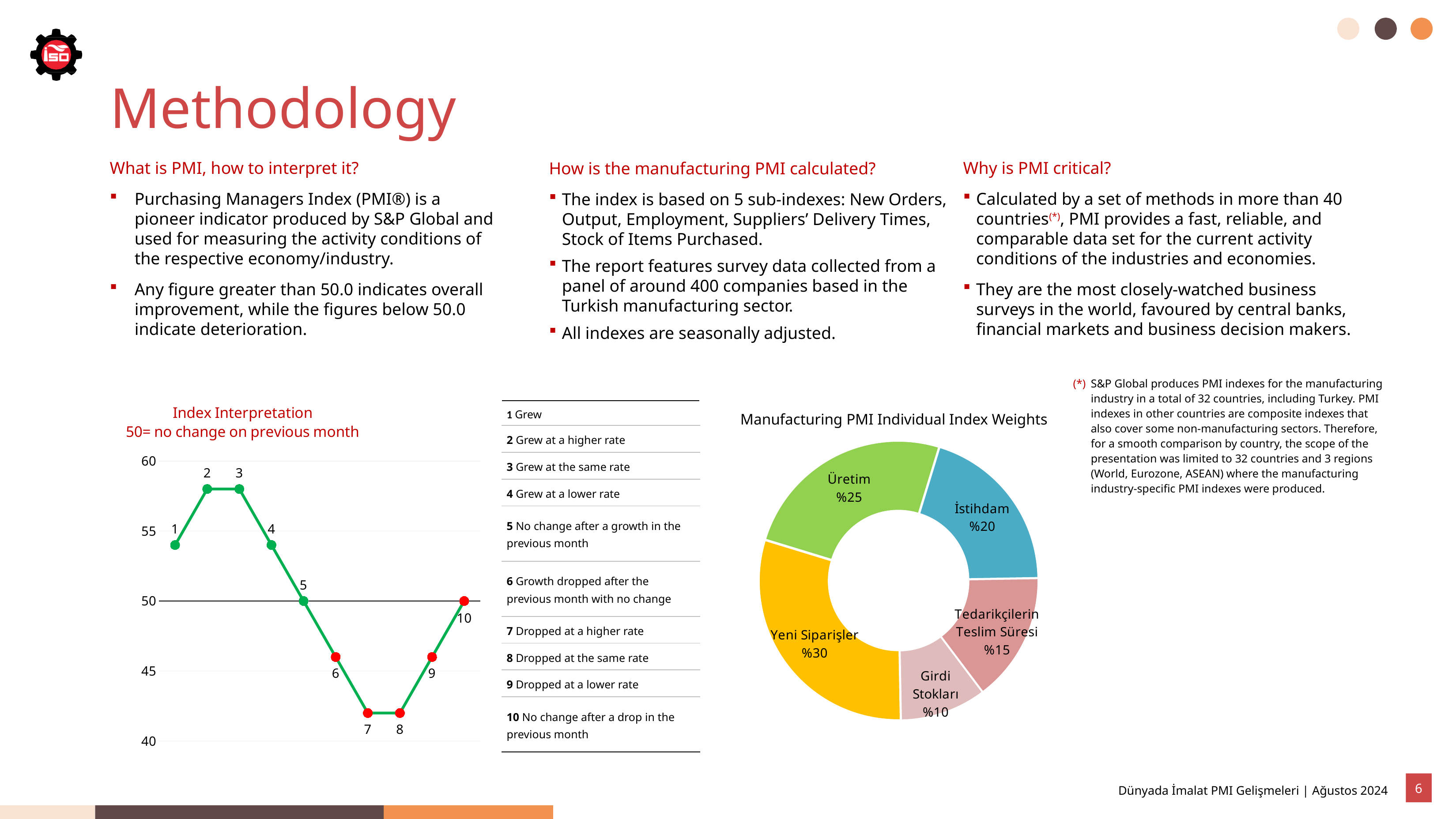
In the Manufacturing PMI Individual Index Weights chart, which has a larger weight, Tedarikçilerin Teslim Süresi or İstihdam? İstihdam What kind of chart is the Manufacturing PMI Individual Index Weights chart? Doughnut chart In the Manufacturing PMI Individual Index Weights chart, which component has the largest weight? Yeni Siparişler In the Index Interpretation chart, is the value at point 7 greater or less than 45? less How many components are shown in the Manufacturing PMI Individual Index Weights chart? 5 In the Manufacturing PMI Individual Index Weights chart, what is the weight of Girdi Stokları? %10 In the Manufacturing PMI Individual Index Weights chart, which component has the smallest weight? Girdi Stokları In the Manufacturing PMI Individual Index Weights chart, what is the difference between the weights of Üretim and İstihdam? %5 In the Index Interpretation chart, what value does point 5 land on? 50 How many numbered points are plotted in the Index Interpretation chart? 10 In the Manufacturing PMI Individual Index Weights chart, what is the weight of Yeni Siparişler? %30 In the Index Interpretation chart, is the value at point 2 greater or less than 55? greater